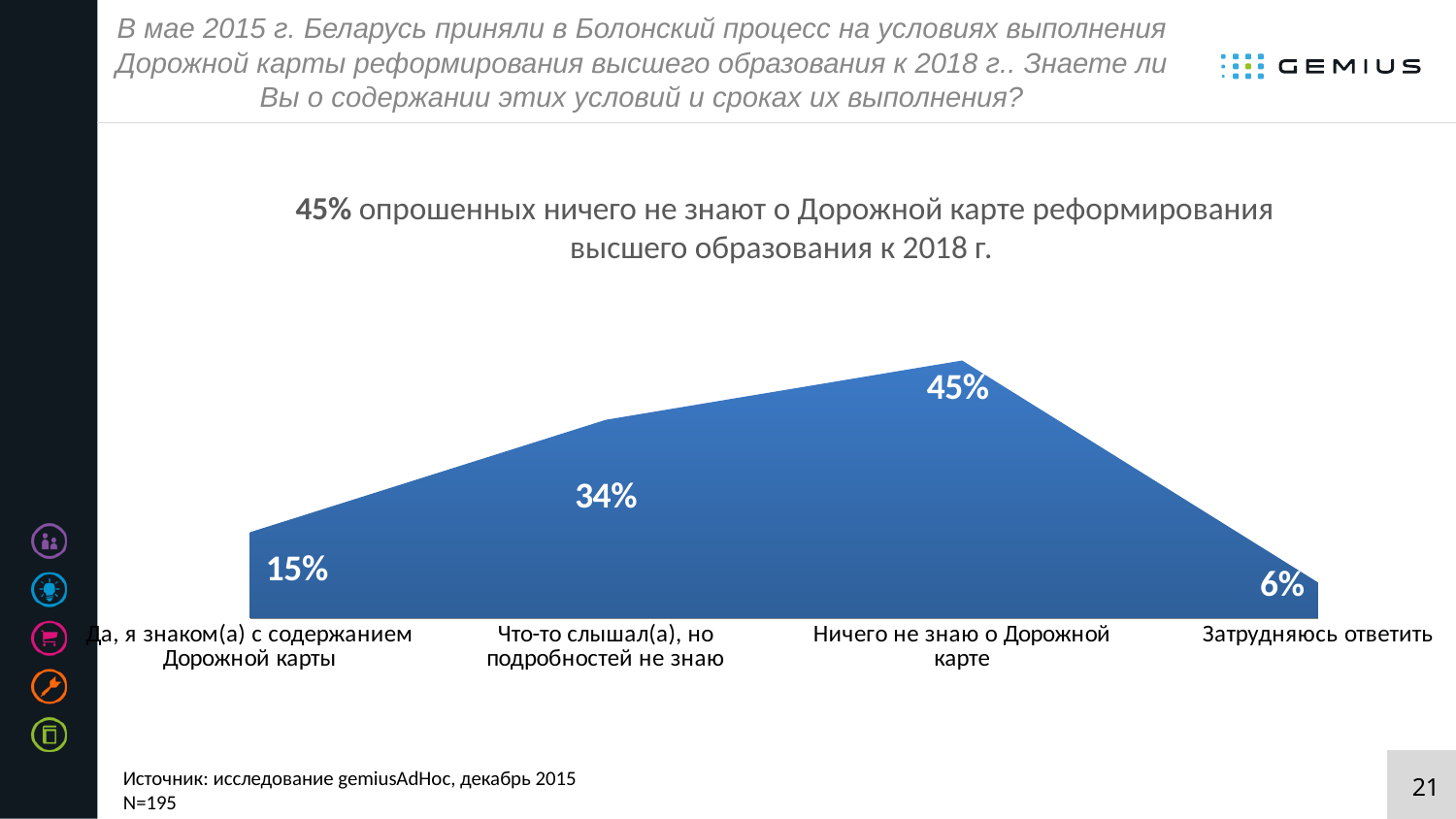
What share of respondents chose "Что-то слышал(а), но подробностей не знаю"? 34% Which is larger: the value for "Что-то слышал(а), но подробностей не знаю" or for "Да, я знаком(а) с содержанием Дорожной карты"? Что-то слышал(а), но подробностей не знаю What is the difference between the values for "Ничего не знаю о Дорожной карте" and "Что-то слышал(а), но подробностей не знаю"? 11% How many answer categories are shown in the chart? 4 Which answer option has the lowest value? Затрудняюсь ответить What is the value for "Затрудняюсь ответить"? 6% What kind of chart is shown on the slide? Area chart What is the difference between the values for "Да, я знаком(а) с содержанием Дорожной карты" and "Затрудняюсь ответить"? 9% What is the value for "Да, я знаком(а) с содержанием Дорожной карты"? 15% What percentage of respondents answered "Ничего не знаю о Дорожной карте"? 45% What is the sample size (N) stated on the slide? N=195 Which answer option has the highest value? Ничего не знаю о Дорожной карте